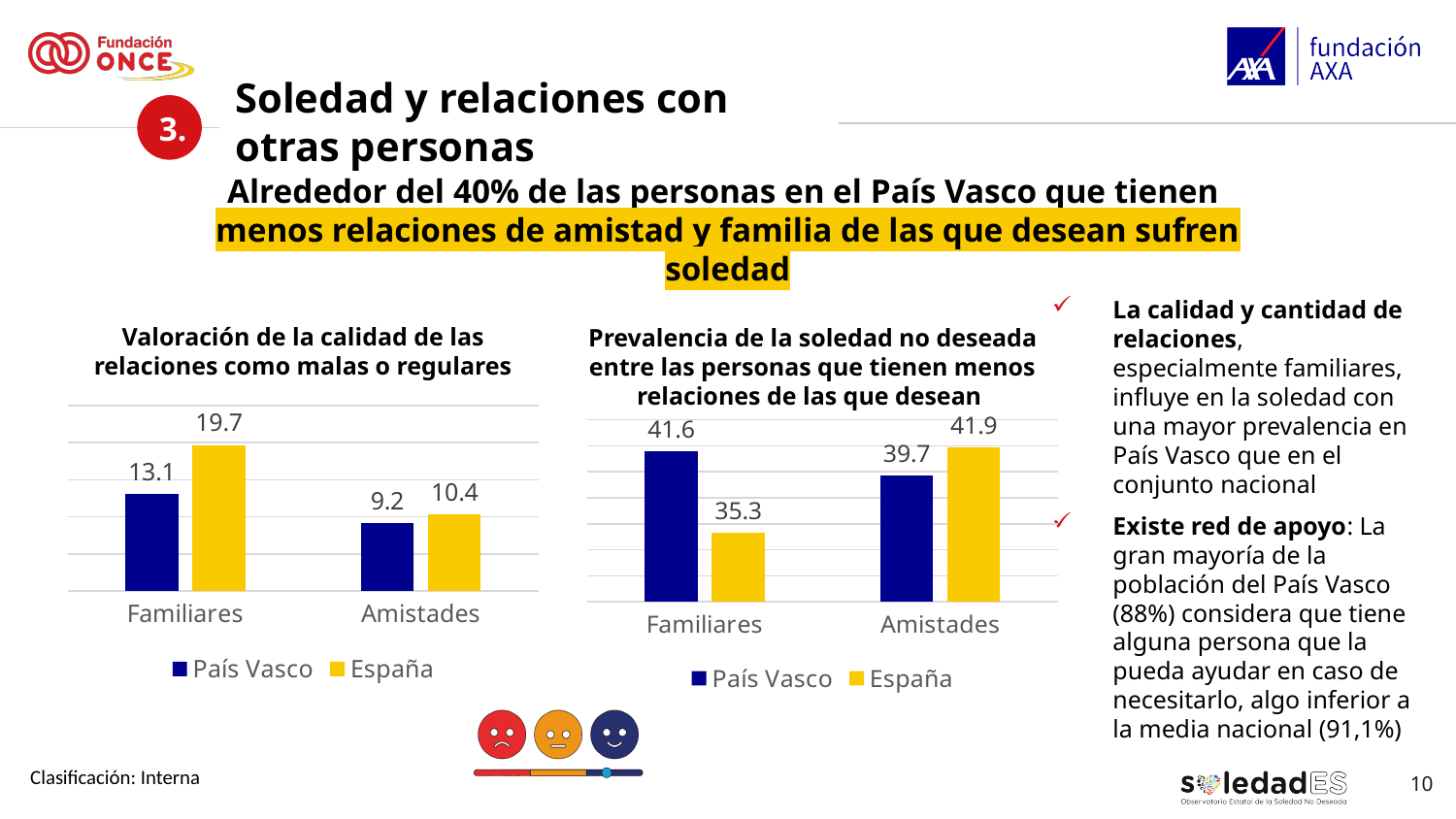
How many series does the legend of the left chart, 'Valoración de la calidad de las relaciones como malas o regulares', list? 2 In the right chart, 'Prevalencia de la soledad no deseada entre las personas que tienen menos relaciones de las que desean', what is the value for España in the Amistades category? 41.9 What kind of chart is the right chart, 'Prevalencia de la soledad no deseada entre las personas que tienen menos relaciones de las que desean'? Bar chart In the right chart, 'Prevalencia de la soledad no deseada entre las personas que tienen menos relaciones de las que desean', what is the value for País Vasco in the Familiares category? 41.6 In the left chart, 'Valoración de la calidad de las relaciones como malas o regulares', which is larger for Amistades: País Vasco or España? España In the left chart, 'Valoración de la calidad de las relaciones como malas o regulares', what is the value for España in the Amistades category? 10.4 In the right chart, 'Prevalencia de la soledad no deseada entre las personas que tienen menos relaciones de las que desean', what is the difference between País Vasco and España in the Familiares category? 6.3 In the left chart, 'Valoración de la calidad de las relaciones como malas o regulares', what is the difference between España and País Vasco in the Familiares category? 6.6 In the left chart, 'Valoración de la calidad de las relaciones como malas o regulares', which bar has the highest value? España, Familiares In the left chart, 'Valoración de la calidad de las relaciones como malas o regulares', what is the value for País Vasco in the Familiares category? 13.1 In the right chart, 'Prevalencia de la soledad no deseada entre las personas que tienen menos relaciones de las que desean', which bar has the lowest value? España, Familiares In the right chart, 'Prevalencia de la soledad no deseada entre las personas que tienen menos relaciones de las que desean', which is larger for Familiares: País Vasco or España? País Vasco